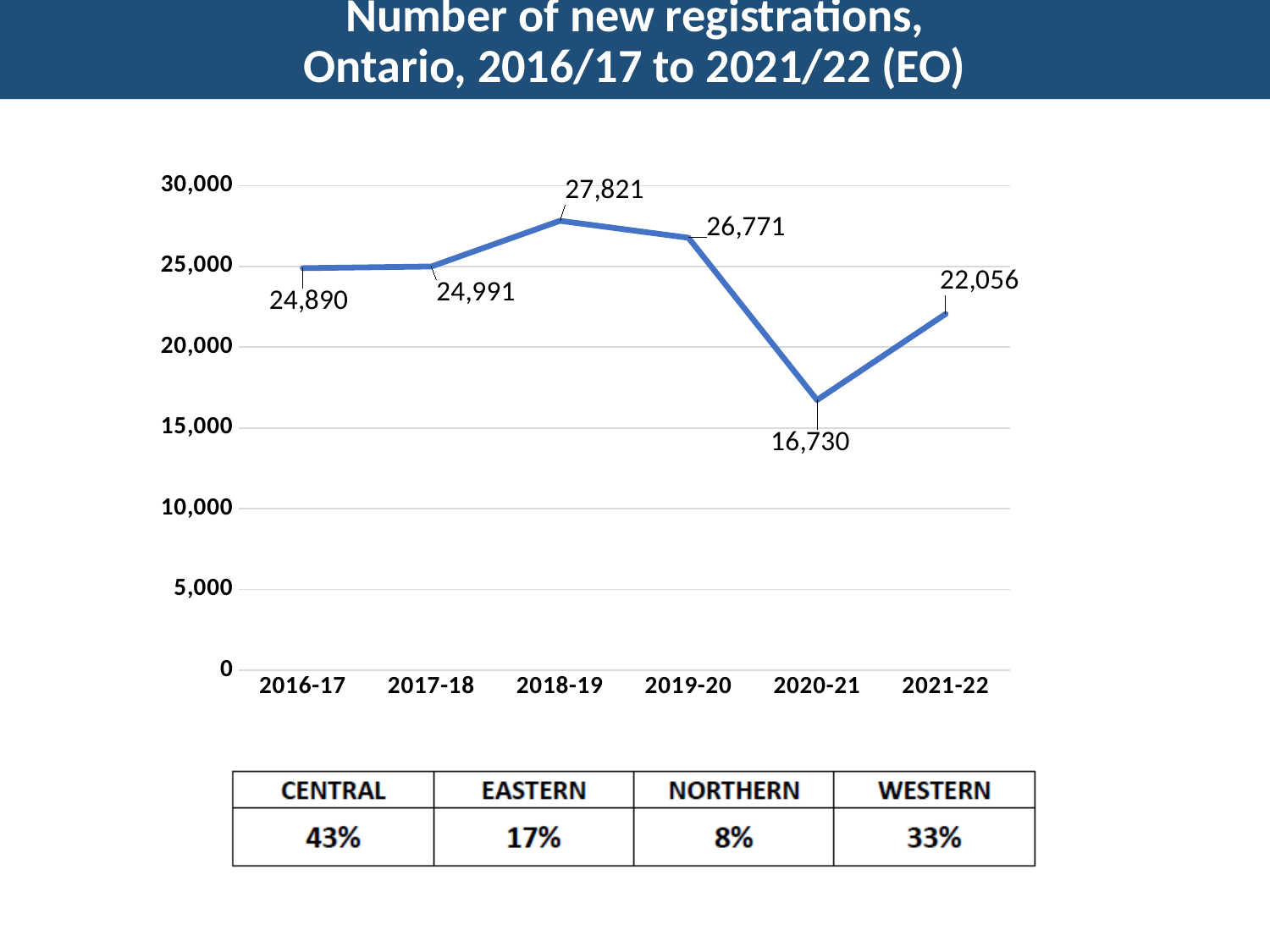
What is the number of new registrations in 2020-21? 16,730 What is the difference in new registrations between 2021-22 and 2020-21? 5,326 Is the value for 2021-22 greater or less than 20,000? greater What is the difference in new registrations between 2018-19 and 2020-21? 11,091 What is the number of new registrations in 2018-19? 27,821 Which year has the lowest number of new registrations? 2020-21 Which year had more new registrations, 2019-20 or 2021-22? 2019-20 Do new registrations rise or fall from 2019-20 to 2020-21? fall What is the number of new registrations in 2016-17? 24,890 Which year has the highest number of new registrations? 2018-19 What kind of chart is shown on the slide? line chart How many years are plotted on the chart? 6